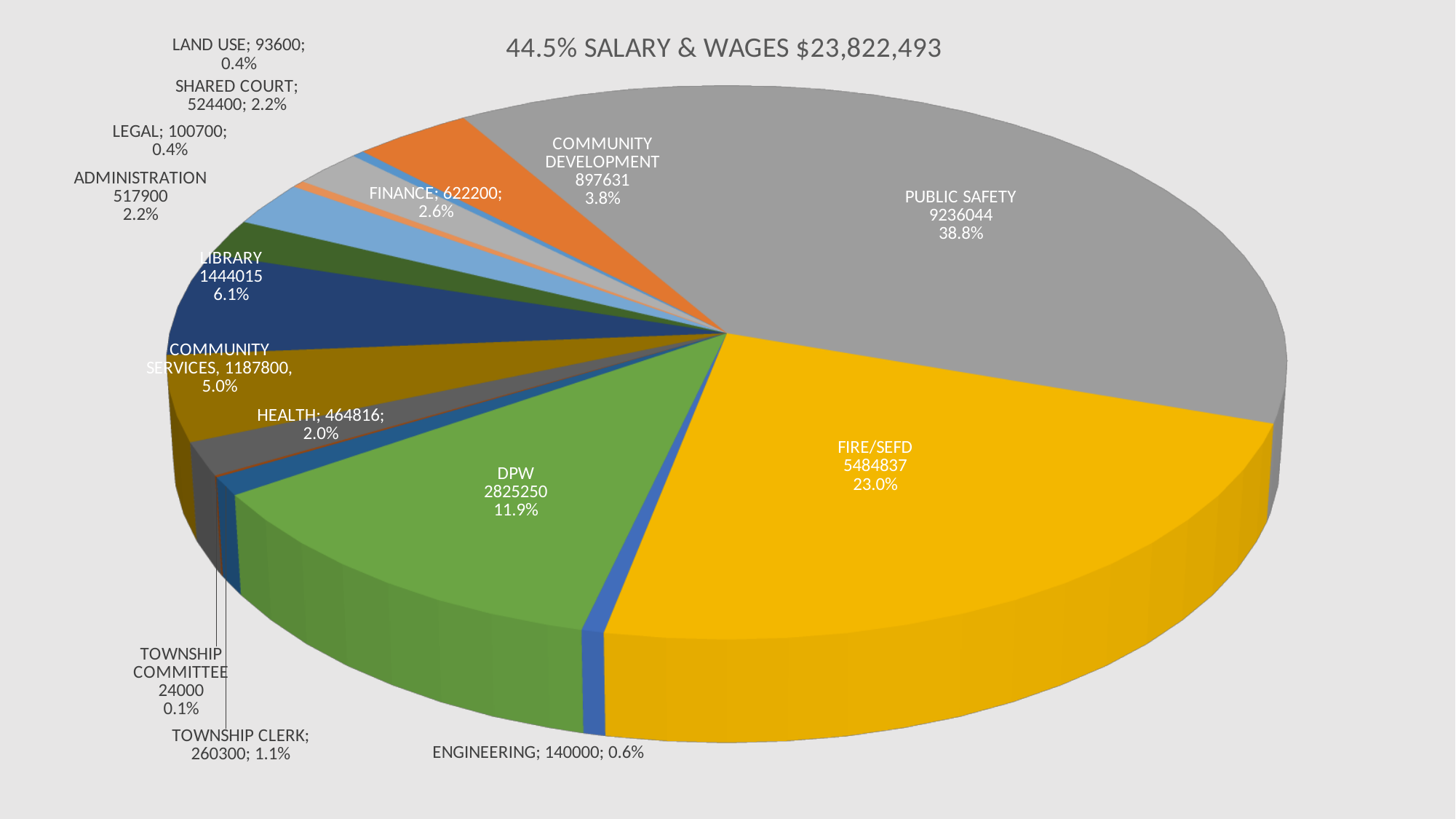
What kind of chart is shown on the slide? Pie chart What is the title of the chart? 44.5% SALARY & WAGES $23,822,493 How many categories are shown in the pie chart? 15 What percentage share does LIBRARY have? 6.1% Which is larger, LIBRARY or COMMUNITY SERVICES? LIBRARY What is the value for SHARED COURT? 524400 Which category has the largest slice? PUBLIC SAFETY What is the difference between the values for PUBLIC SAFETY and FIRE/SEFD? 3751207 What percentage share does FIRE/SEFD have? 23.0% Which category has the smallest slice? TOWNSHIP COMMITTEE What is the value for DPW? 2825250 What is the value for PUBLIC SAFETY? 9236044